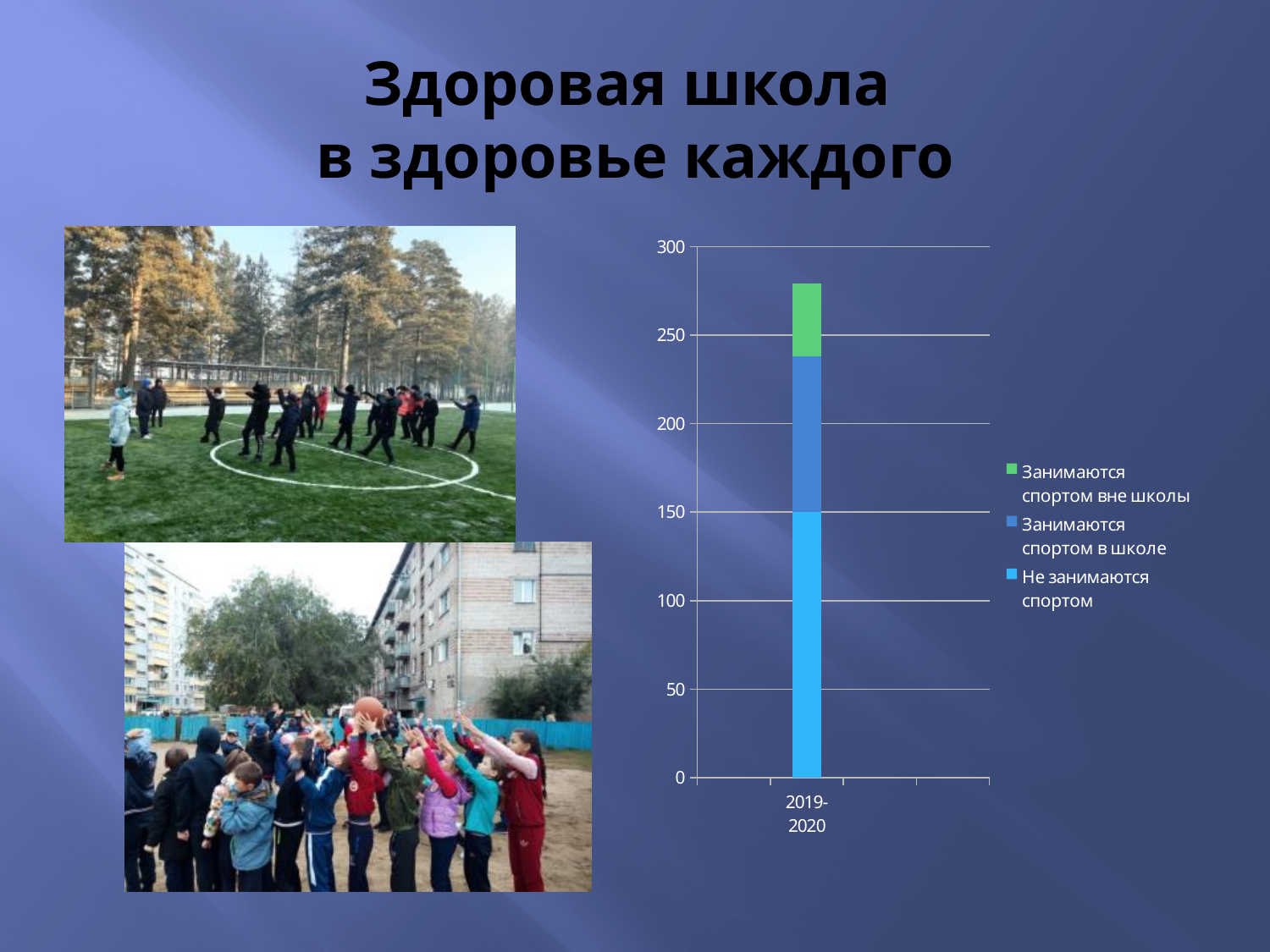
Which series has the largest segment in the 2019-2020 bar? Не занимаются спортом Is the total height of the 2019-2020 stacked bar greater or less than 250? greater What is the category label on the x axis of the chart? 2019-2020 How many categories are shown on the x axis of the chart? 1 How many series does the chart legend list? 3 Which segment is larger in the 2019-2020 bar: 'Занимаются спортом в школе' or 'Занимаются спортом вне школы'? Занимаются спортом в школе Which series has the smallest segment in the 2019-2020 bar? Занимаются спортом вне школы Which legend entry is shown in green in the chart? Занимаются спортом вне школы Is the value for 'Занимаются спортом в школе' in 2019-2020 greater or less than 100? less What is the value for 'Не занимаются спортом' in 2019-2020? 150 Is the total height of the 2019-2020 stacked bar greater or less than 300? less What kind of chart is shown on the slide? stacked bar chart